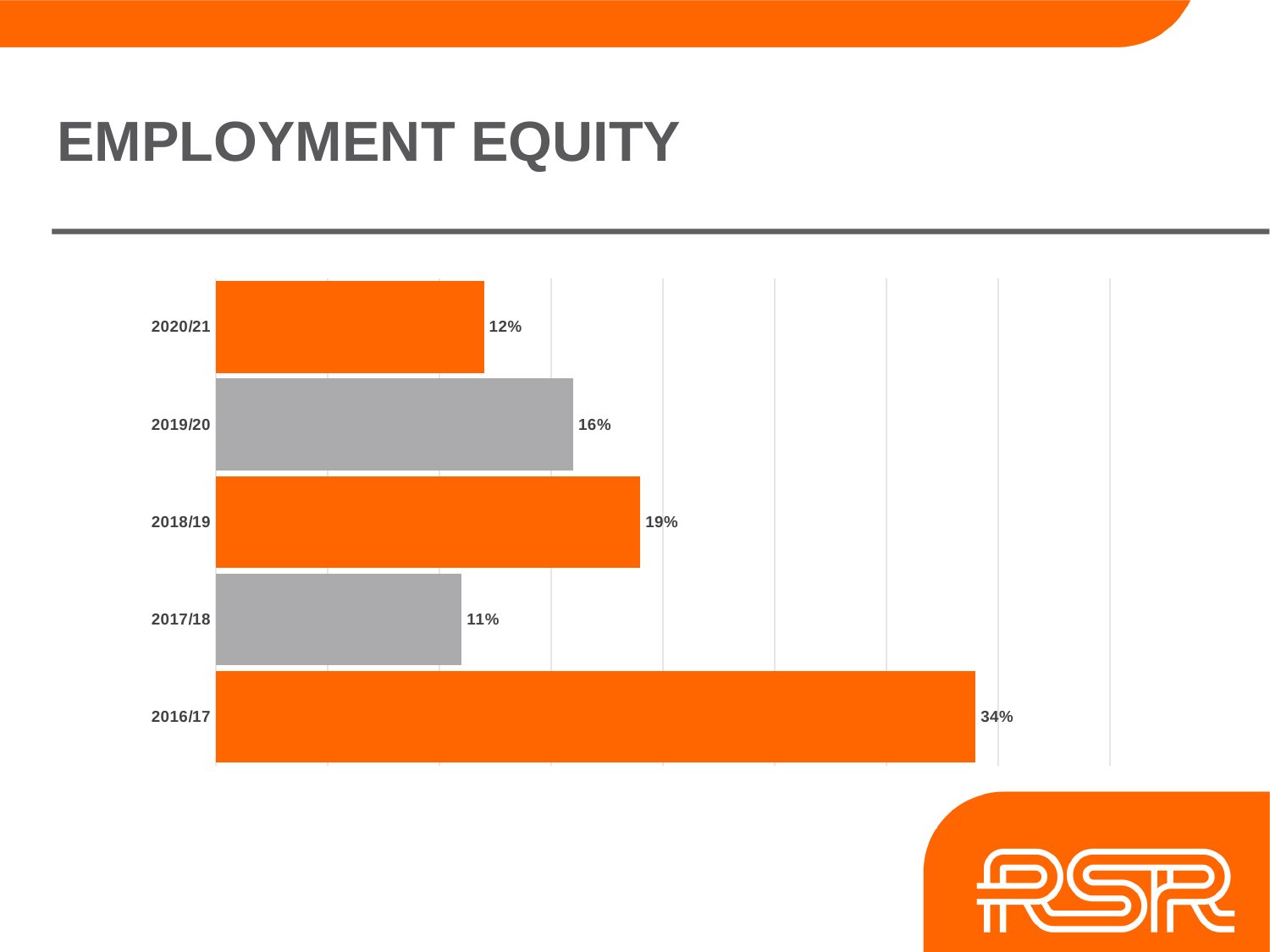
What is the difference between the values for 2019/20 and 2020/21? 4% What is the value for 2016/17? 34% What is the difference between the values for 2016/17 and 2018/19? 15% Which year has the highest value? 2016/17 What is the title of the slide containing the chart? EMPLOYMENT EQUITY Which is larger, the value for 2019/20 or the value for 2020/21? 2019/20 What is the value for 2017/18? 11% What kind of chart is shown on the slide? Bar chart How many years are shown in the chart? 5 Which year has the lowest value? 2017/18 What is the value for 2020/21? 12% What is the value for 2018/19? 19%